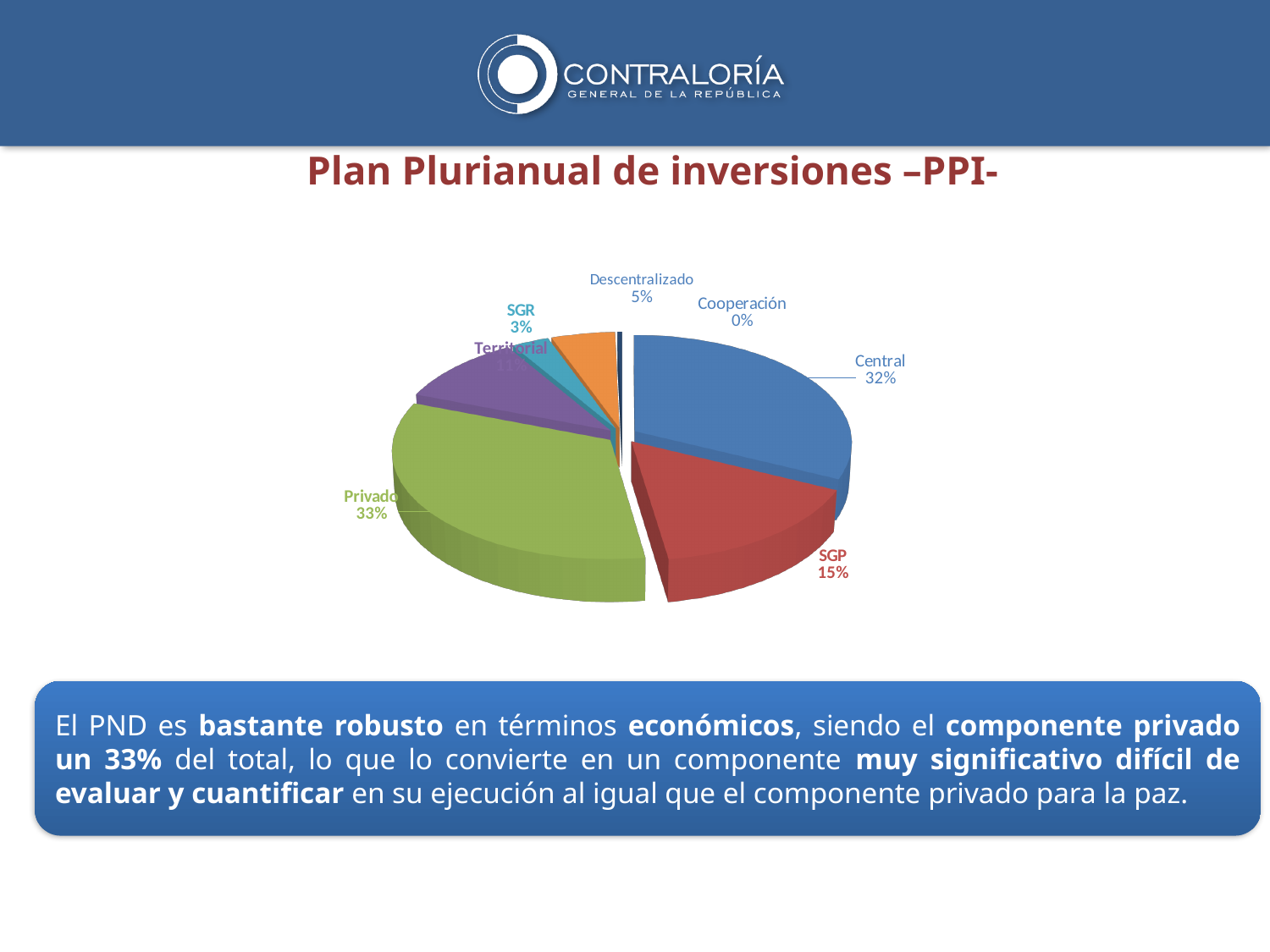
What is the title of the slide containing the pie chart? Plan Plurianual de inversiones –PPI- What is the value shown for Descentralizado? 5% What is the value shown for SGP? 15% What kind of chart is shown on the slide? pie chart What is the value shown for Cooperación? 0% Which is larger, the SGP slice or the Descentralizado slice? SGP What share of the pie does the Central slice represent? 32% What is the value shown for SGR? 3% What is the difference in percentage points between the Central slice and the SGP slice? 17 Which slice has the smallest share of the pie? Cooperación How many slices does the pie chart have? 7 What share of the pie does the Privado slice represent? 33%